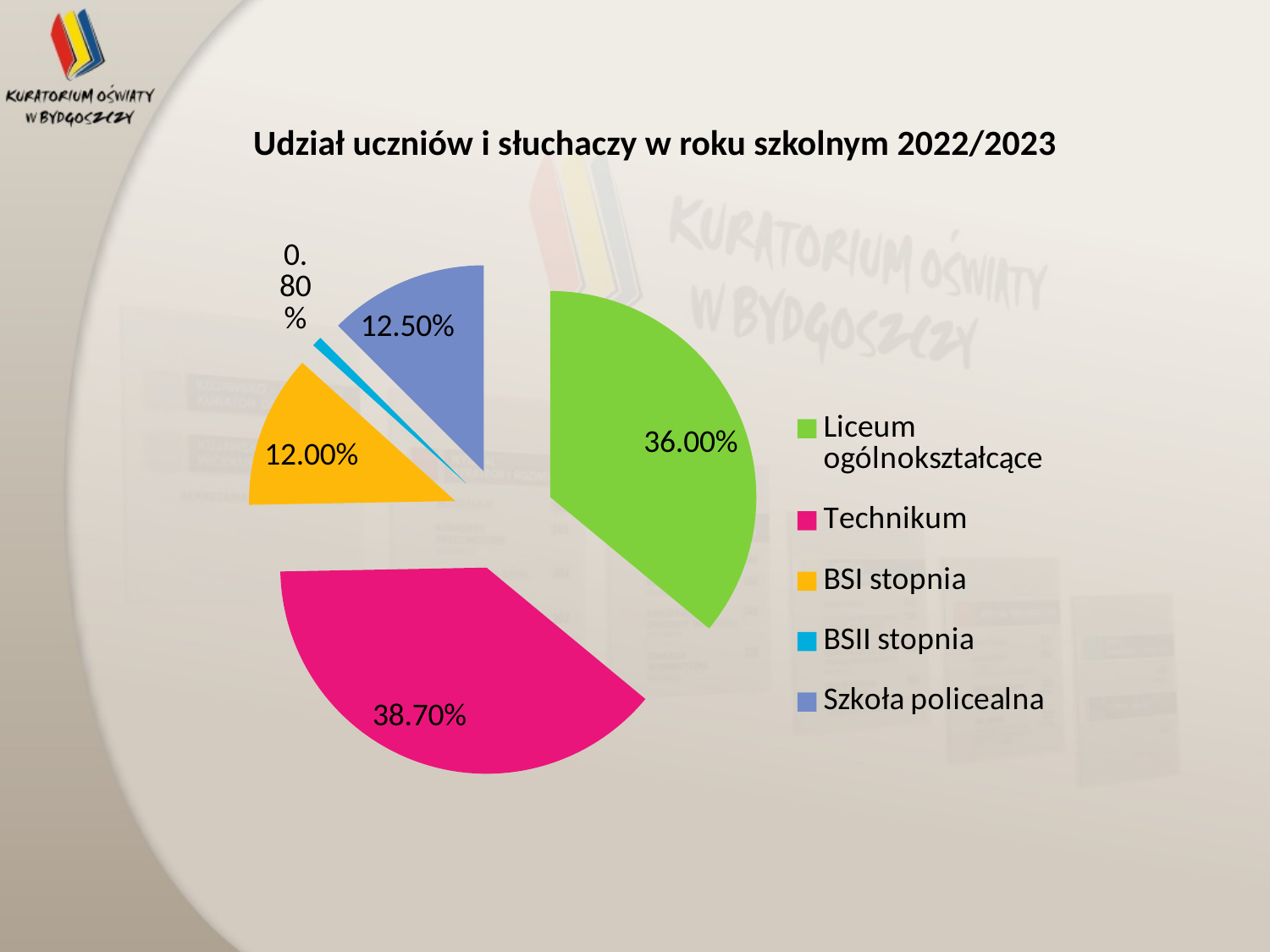
Which is larger, the share for Szkoła policealna or the share for BSI stopnia? Szkoła policealna What is the difference between the shares of Technikum and Liceum ogólnokształcące? 2.70% Which category has the smallest share of the pie? BSII stopnia What kind of chart is shown on the slide? pie chart What is the share for BSII stopnia? 0.80% Which category has the largest share of the pie? Technikum What is the title of the chart? Udział uczniów i słuchaczy w roku szkolnym 2022/2023 What is the share for Szkoła policealna? 12.50% What is the share for Technikum? 38.70% What is the share for BSI stopnia? 12.00% How many categories does the legend list? 5 What is the share for Liceum ogólnokształcące? 36.00%